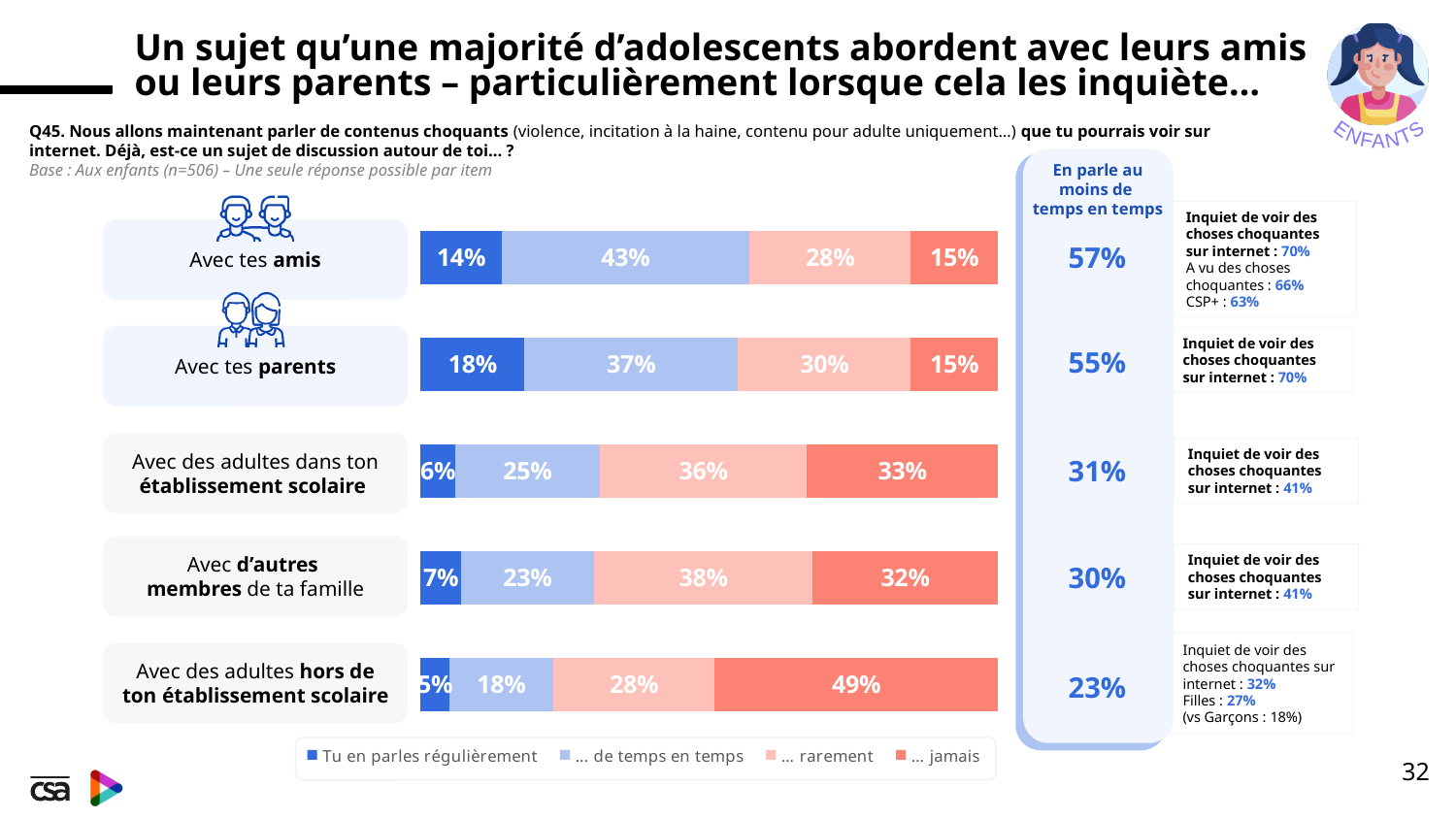
Which has the larger "… rarement" value: "Avec tes amis" or "Avec d'autres membres de ta famille"? Avec d'autres membres de ta famille Which category has the lowest "Tu en parles régulièrement" value? Avec des adultes hors de ton établissement scolaire Which category has the highest "… jamais" value? Avec des adultes hors de ton établissement scolaire What is the difference between the "… de temps en temps" values for "Avec tes amis" and "Avec tes parents"? 6 percentage points What percentage of children say they talk regularly ("Tu en parles régulièrement") about shocking content with their parents ("Avec tes parents")? 18% What is the "… rarement" value for "Avec des adultes dans ton établissement scolaire"? 36% How many categories are shown in the bar chart? 5 What kind of chart is shown on the slide? Stacked bar chart What is the total of the stacked bar for "Avec tes amis"? 100% What is the first entry in the chart legend? Tu en parles régulièrement How many series does the legend list? 4 What is the "… jamais" value for "Avec des adultes hors de ton établissement scolaire"? 49%